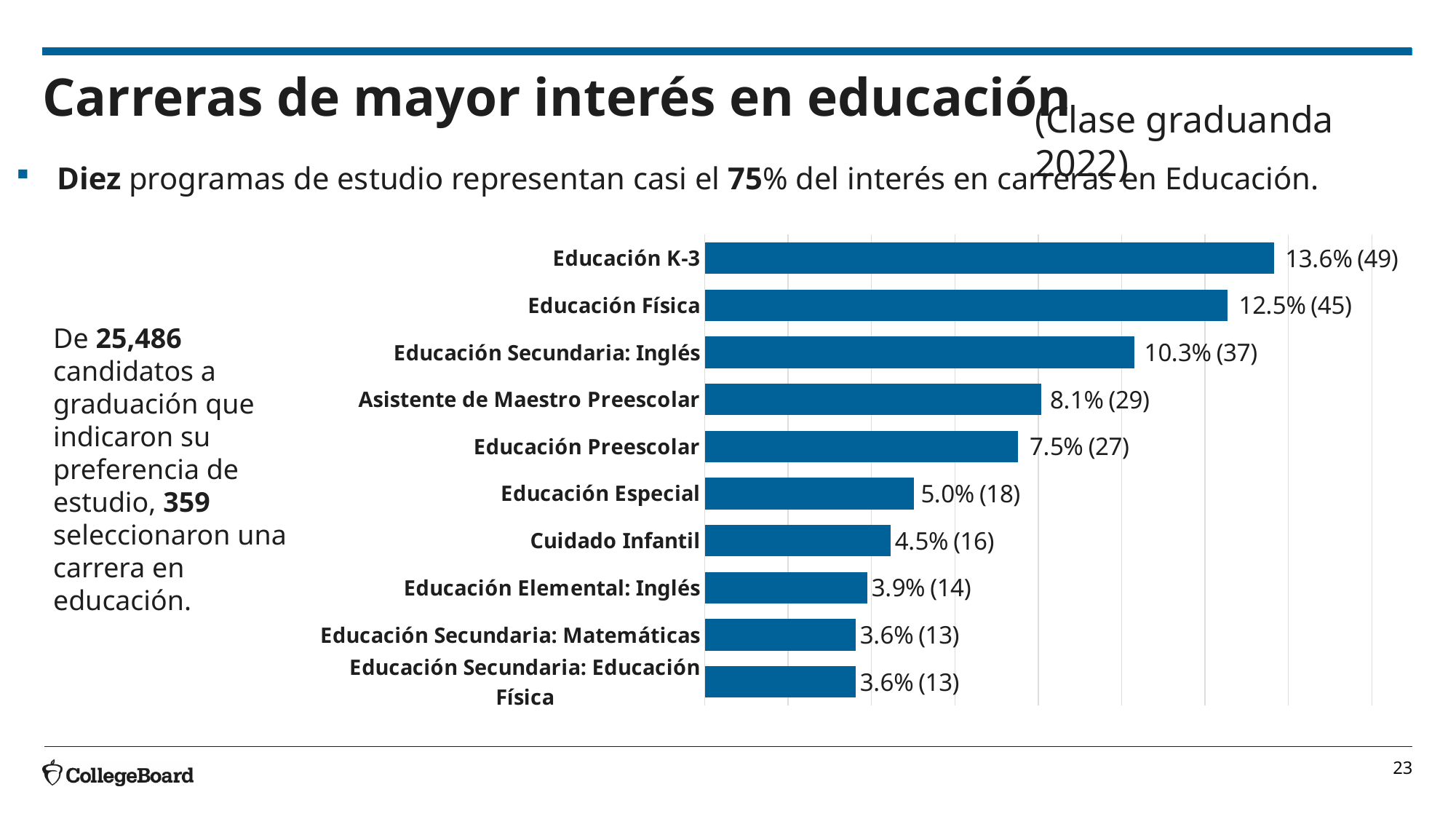
Which is larger, the value for Cuidado Infantil or the value for Educación Elemental: Inglés? Cuidado Infantil What is the value shown for Educación K-3? 13.6% (49) Which category has the highest value? Educación K-3 What is the count shown for Educación Preescolar? 27 What is the difference in percentage between Educación Secundaria: Inglés and Educación Preescolar? 2.8% What kind of chart is shown on the slide? Bar chart What is the value shown for Educación Especial? 5.0% (18) What is the value shown for Asistente de Maestro Preescolar? 8.1% (29) How many categories are shown in the chart? 10 What is the difference in count between Educación K-3 and Educación Física? 4 What colour are the bars in the chart? Blue Which two categories share the same value of 3.6% (13)? Educación Secundaria: Matemáticas and Educación Secundaria: Educación Física